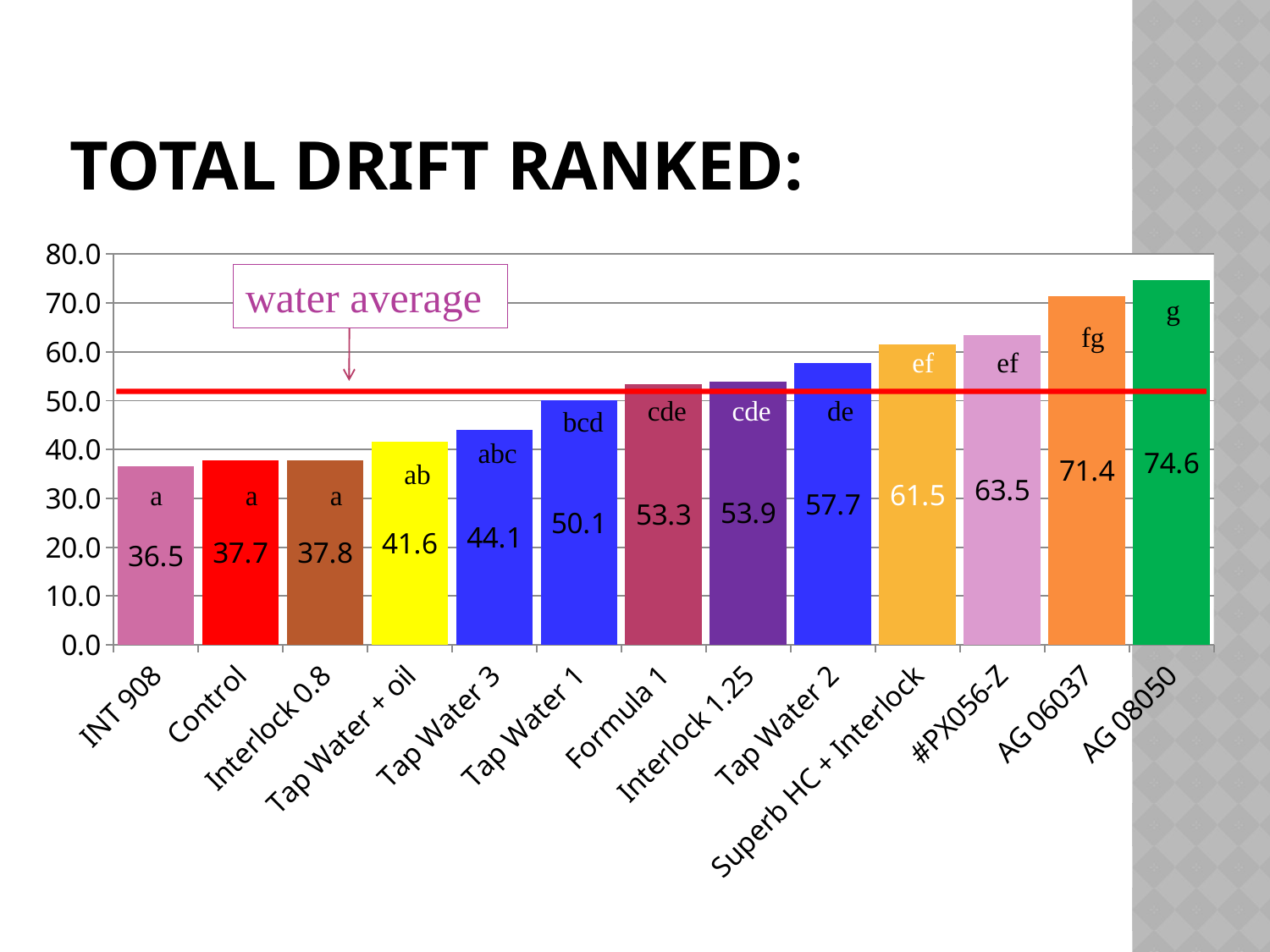
Which category has the highest value? AG 08050 Is the value for Tap Water 1 greater or less than 40.0? greater Which is larger, the value for Tap Water 2 or the value for Formula 1? Tap Water 2 What is the difference between the values for AG 08050 and INT 908? 38.1 What is the value for Tap Water 3? 44.1 How many categories are shown on the x axis? 13 What is the value for Superb HC + Interlock? 61.5 What is the value for Control? 37.7 What kind of chart is shown on the slide? bar chart What is the difference between the values for AG 06037 and #PX056-Z? 7.9 Which category has the lowest value? INT 908 What does the red horizontal line on the chart represent? water average